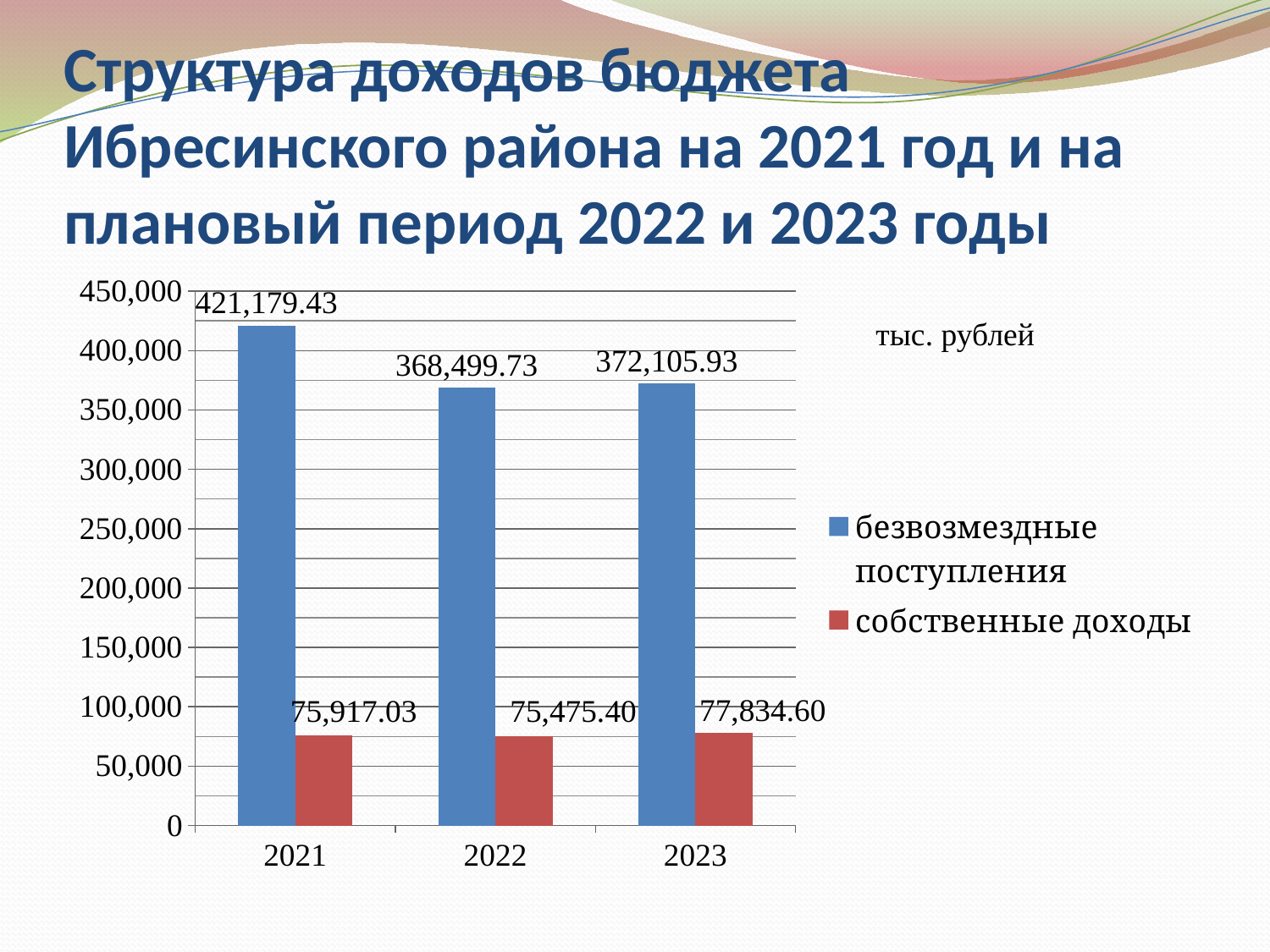
What is the difference between собственные доходы in 2023 and in 2022? 2,359.20 In which year is безвозмездные поступления highest? 2021 How many years are shown on the x axis? 3 In which year is собственные доходы lowest? 2022 Which is larger: безвозмездные поступления in 2022 or in 2023? 2023 How many series does the legend list? 2 What is the value of безвозмездные поступления for 2021? 421,179.43 What kind of chart is shown on the slide? bar chart What is the value of собственные доходы for 2023? 77,834.60 What is the difference between безвозмездные поступления in 2021 and in 2022? 52,679.70 What is the value of безвозмездные поступления for 2022? 368,499.73 Is the value of собственные доходы for 2021 greater or less than 100,000? less